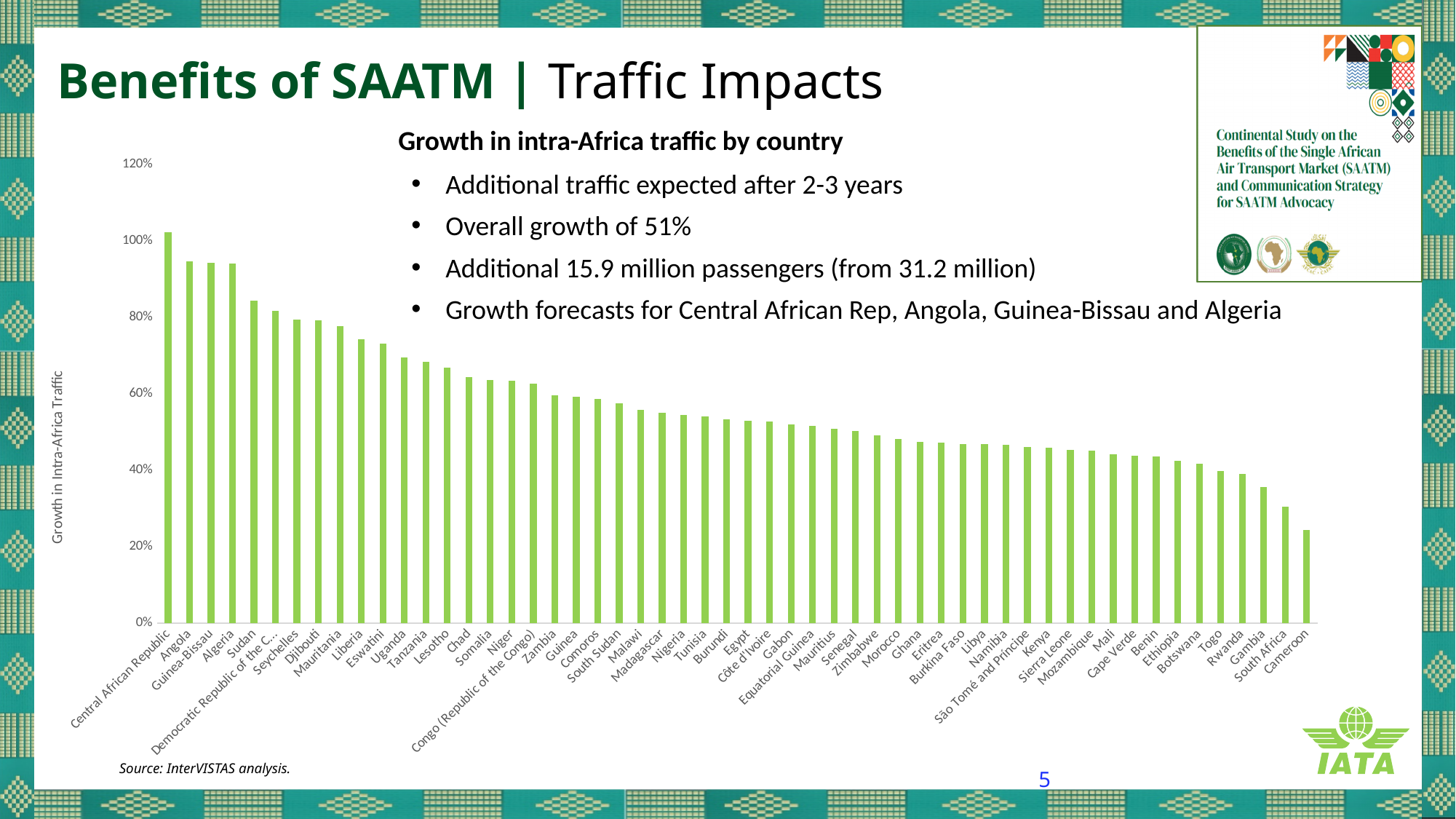
What source is cited for the chart? InterVISTAS analysis Which country has the lowest growth in intra-Africa traffic on the chart? Cameroon What is the label on the vertical axis of the chart? Growth in Intra-Africa Traffic What kind of chart is used to show growth in intra-Africa traffic by country? Bar chart Is the value for Sudan greater or less than 80%? greater Is the value for Central African Republic greater or less than 100%? greater Which country has the highest growth in intra-Africa traffic on the chart? Central African Republic Is the value for Cameroon greater or less than 40%? less Which has the larger growth value, Rwanda or Uganda? Uganda Do the bar values rise or fall moving from left to right along the x axis? Fall Which has the larger growth value, Angola or Kenya? Angola